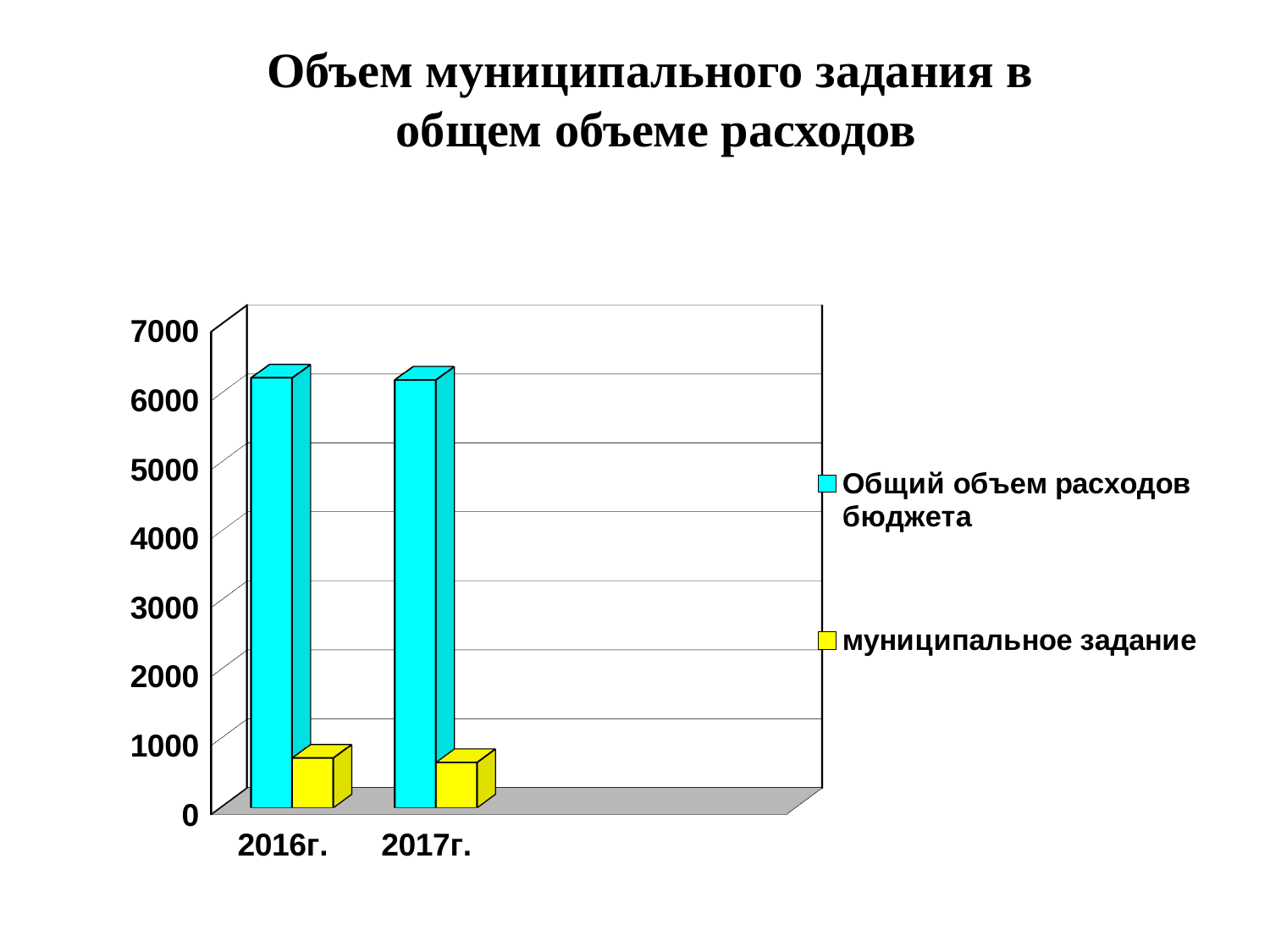
Which series has the lowest value on the chart? муниципальное задание In 2016г., which is larger: Общий объем расходов бюджета or муниципальное задание? Общий объем расходов бюджета Is the value for муниципальное задание in 2016г. greater or less than 1000? less How many categories are shown on the x axis? 2 Which series is shown in yellow? муниципальное задание Is the value for муниципальное задание in 2017г. greater or less than 1000? less How many series does the legend list? 2 What is the title of the chart? Объем муниципального задания в общем объеме расходов Is the value for Общий объем расходов бюджета in 2017г. greater or less than 5000? greater In 2017г., which is larger: Общий объем расходов бюджета or муниципальное задание? Общий объем расходов бюджета What kind of chart is shown on the slide? bar chart